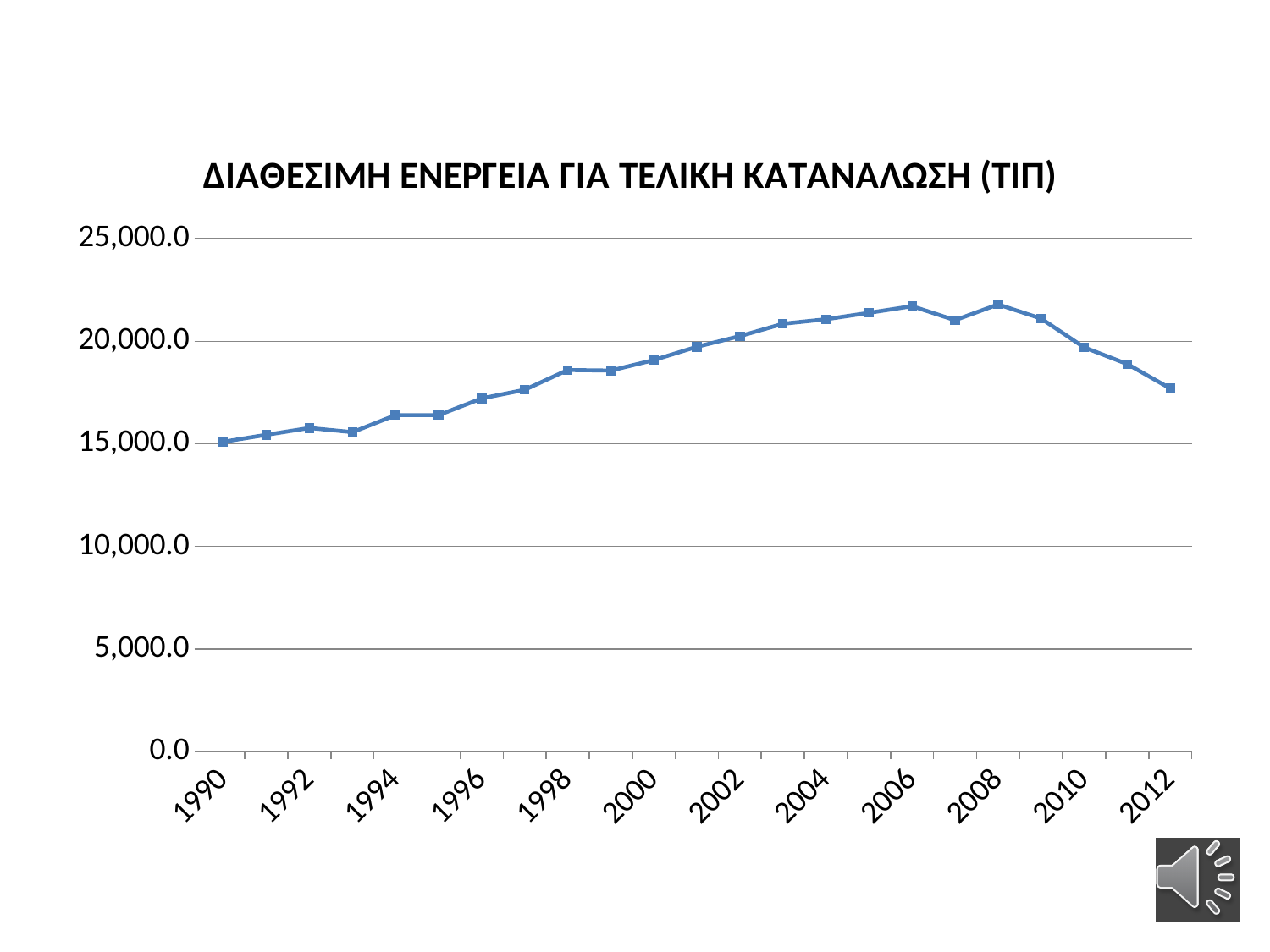
Is the value for 1996 greater or less than 15,000? greater Which year has the lowest value? 1990 Which is larger, the value for 2004 or the value for 1994? 2004 How many data points are plotted on the line? 23 Which is larger, the value for 2012 or the value for 1990? 2012 Is the value for 2012 greater or less than 20,000? less What is the title of the chart? ΔΙΑΘΕΣΙΜΗ ΕΝΕΡΓΕΙΑ ΓΙΑ ΤΕΛΙΚΗ ΚΑΤΑΝΑΛΩΣΗ (ΤΙΠ) What kind of chart is shown on the slide? line chart Is the value for 2006 greater or less than 20,000? greater What is the first year shown on the x axis? 1990 Do the values rise or fall from 2008 to 2012? fall